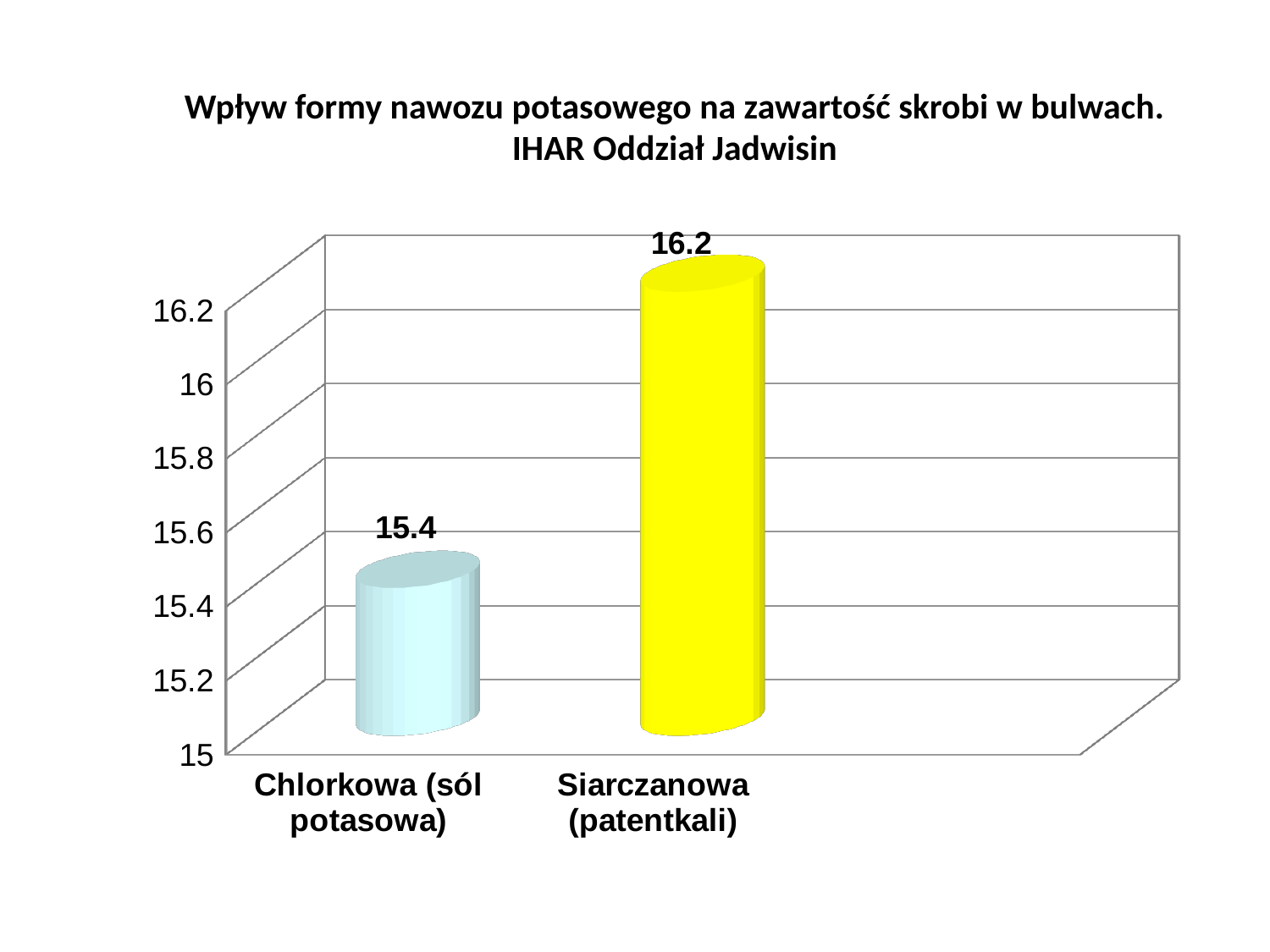
How many categories are shown on the chart? 2 What is the value for Chlorkowa (sól potasowa)? 15.4 What is the title of the chart? Wpływ formy nawozu potasowego na zawartość skrobi w bulwach. IHAR Oddział Jadwisin Is the value for Siarczanowa (patentkali) greater or less than 15.8? greater Which is larger, the value for Chlorkowa (sól potasowa) or the value for Siarczanowa (patentkali)? Siarczanowa (patentkali) Is the value for Chlorkowa (sól potasowa) greater or less than 16? less What colour is the bar for Siarczanowa (patentkali)? yellow Which category has the lowest value? Chlorkowa (sól potasowa) What is the difference between the values for Siarczanowa (patentkali) and Chlorkowa (sól potasowa)? 0.8 What kind of chart is shown on the slide? bar chart Which category has the highest value? Siarczanowa (patentkali) What is the value for Siarczanowa (patentkali)? 16.2